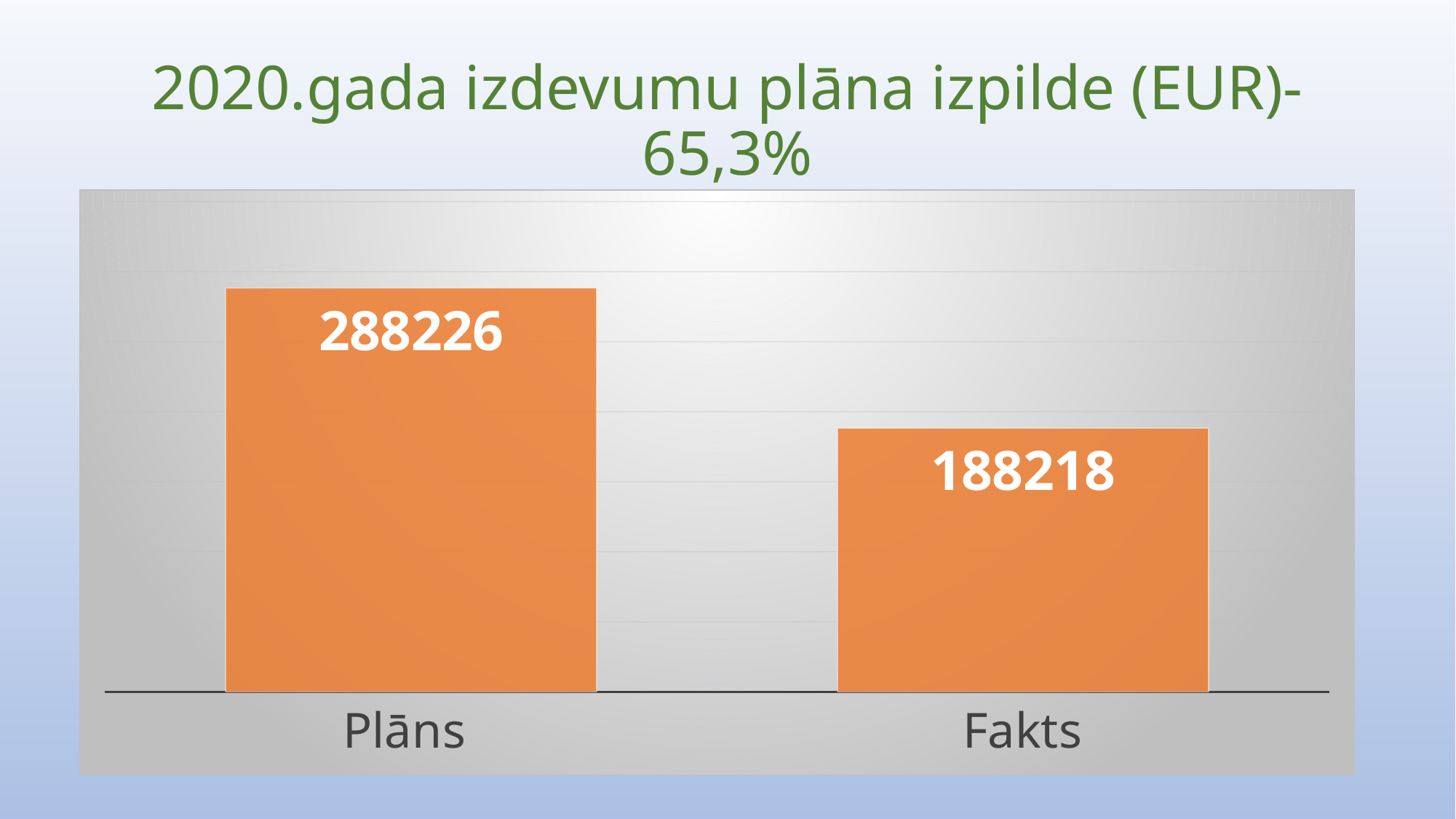
How many categories are shown on the x axis? 2 What kind of chart is shown on the slide? bar chart Which is larger, the value for Plāns or the value for Fakts? Plāns Do the values rise or fall from Plāns to Fakts? fall What is the value for Fakts? 188218 What is the title of the slide? 2020.gada izdevumu plāna izpilde (EUR)- 65,3% Which category has the lowest value? Fakts Which category has the highest value? Plāns What colour are the bars in the chart? orange What is the difference between the values for Plāns and Fakts? 100008 What is the value for Plāns? 288226